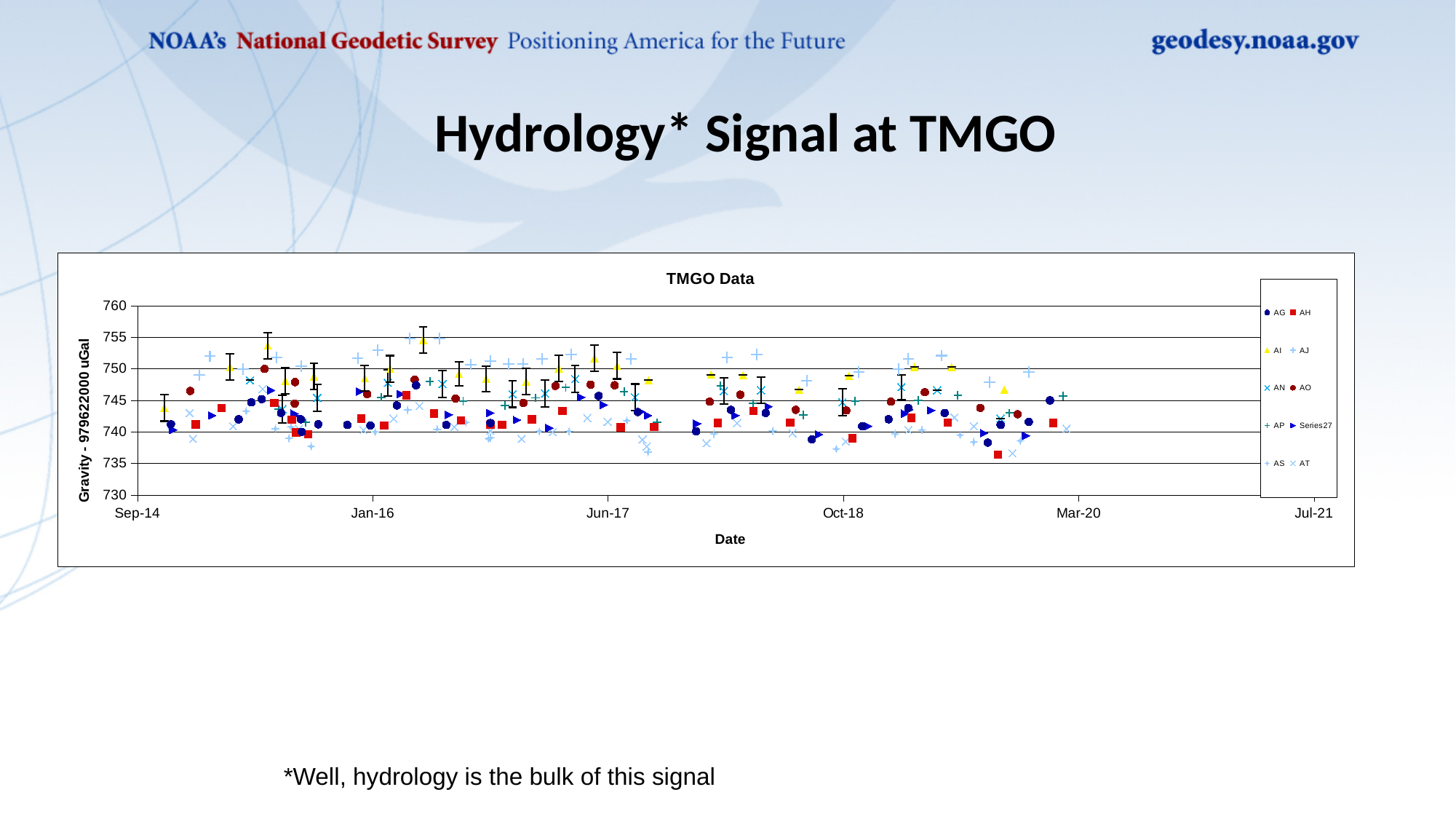
What is the title of the chart on the slide? TMGO Data What kind of chart is the TMGO Data chart? scatter chart What is the first date label on the x axis of the TMGO Data chart? Sep-14 Is the lowest plotted value on the TMGO Data chart greater or less than 740? less What is the lowest value shown on the vertical axis of the TMGO Data chart? 730 What is the label of the vertical axis of the TMGO Data chart? Gravity - 979622000 uGal Is the highest plotted value on the TMGO Data chart greater or less than 760? less What is the highest value shown on the vertical axis of the TMGO Data chart? 760 Is the highest plotted value on the TMGO Data chart greater or less than 750? greater How many date labels are shown along the x axis of the TMGO Data chart? 6 How many series does the legend of the TMGO Data chart list? 10